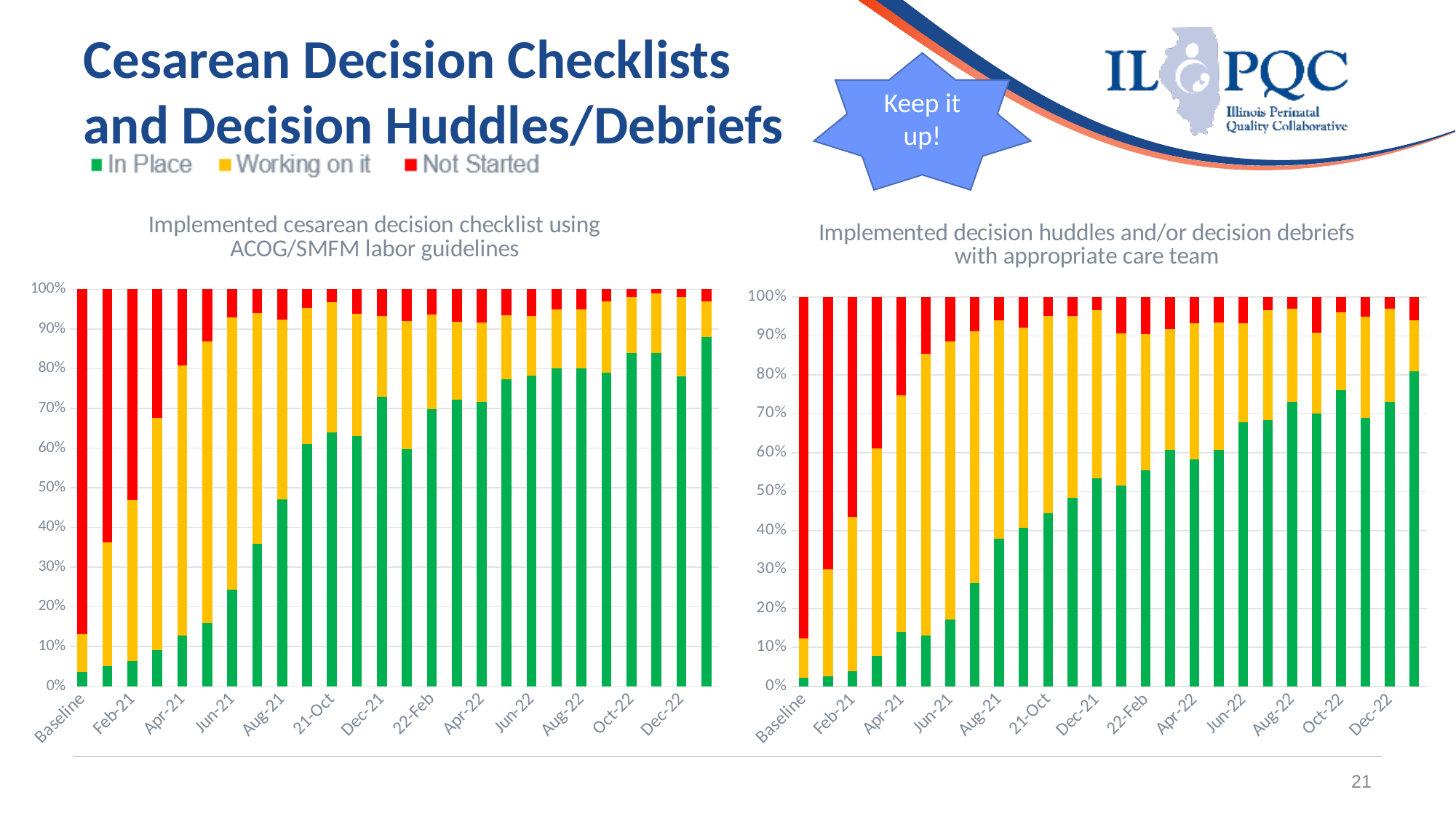
In the left chart (cesarean decision checklist), is the 'Not Started' share for Baseline greater or less than 80%? greater In the left chart (cesarean decision checklist), is the 'In Place' value for Aug-21 greater or less than 40%? greater What kind of chart is the left chart, 'Implemented cesarean decision checklist using ACOG/SMFM labor guidelines'? Stacked bar chart In the right chart (decision huddles/debriefs), is the 'In Place' value for Aug-21 greater or less than 30%? greater In the right chart (decision huddles/debriefs), does the 'In Place' share generally rise or fall from Baseline to Dec-22? Rise How many series does the legend list for the charts on this slide? 3 In the left chart (cesarean decision checklist), which is larger at Baseline: the 'In Place' share or the 'Not Started' share? Not Started What are the three series named in the legend? In Place, Working on it, Not Started Which colour represents 'Not Started' in the charts? Red